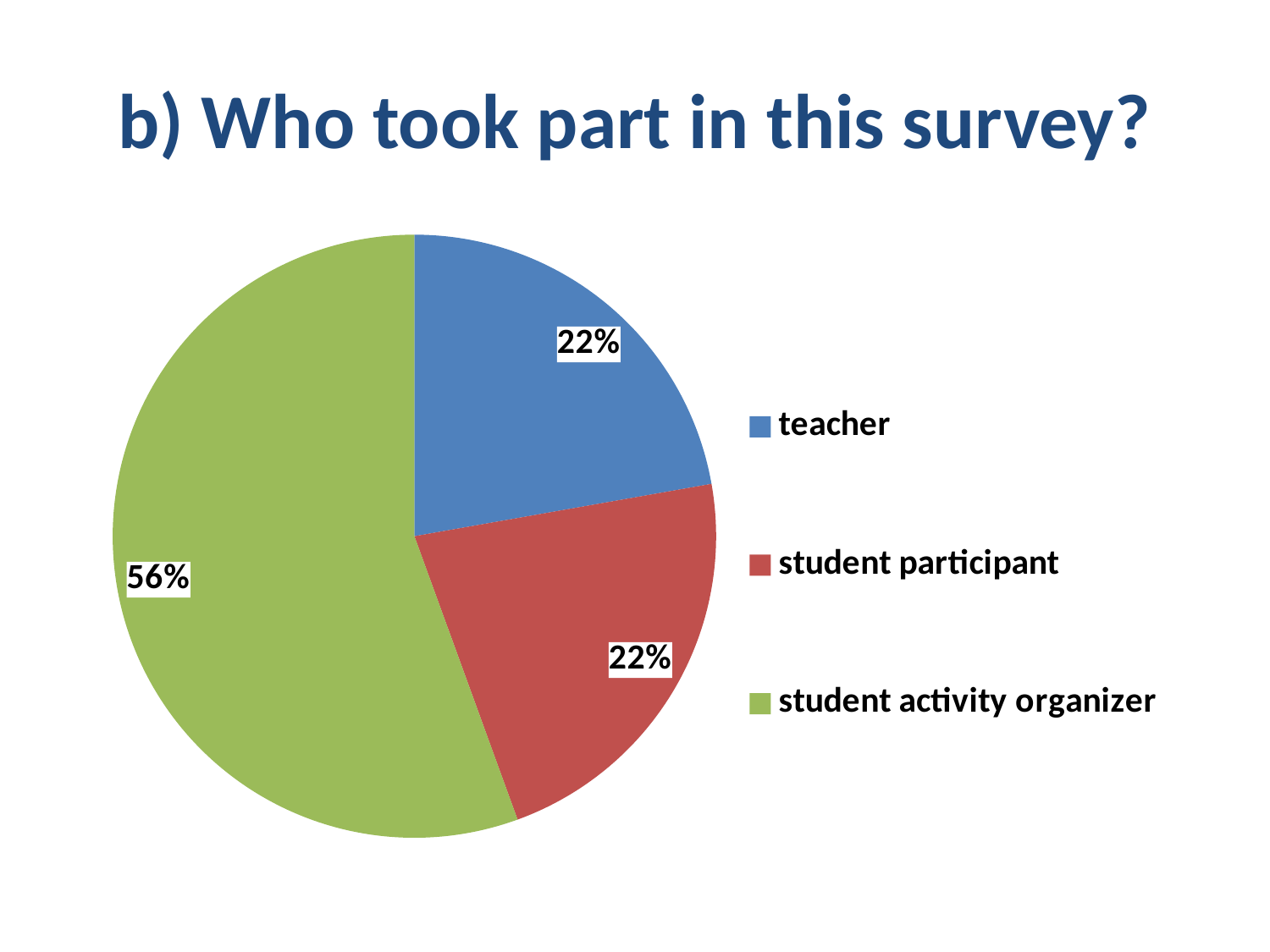
What kind of chart is shown on the slide? pie chart What is the difference between the share for student activity organizer and the share for teacher? 34% What share of the pie is labelled for teacher? 22% What colour is the slice for student participant? red Is the share for student activity organizer greater or less than 50%? greater What share of the pie is labelled for student activity organizer? 56% How many categories does the legend list? 3 Which is larger, the share for student activity organizer or the share for student participant? student activity organizer What share of the pie is labelled for student participant? 22% What is the title of the slide containing the chart? b) Who took part in this survey? Which category has the largest slice of the pie? student activity organizer